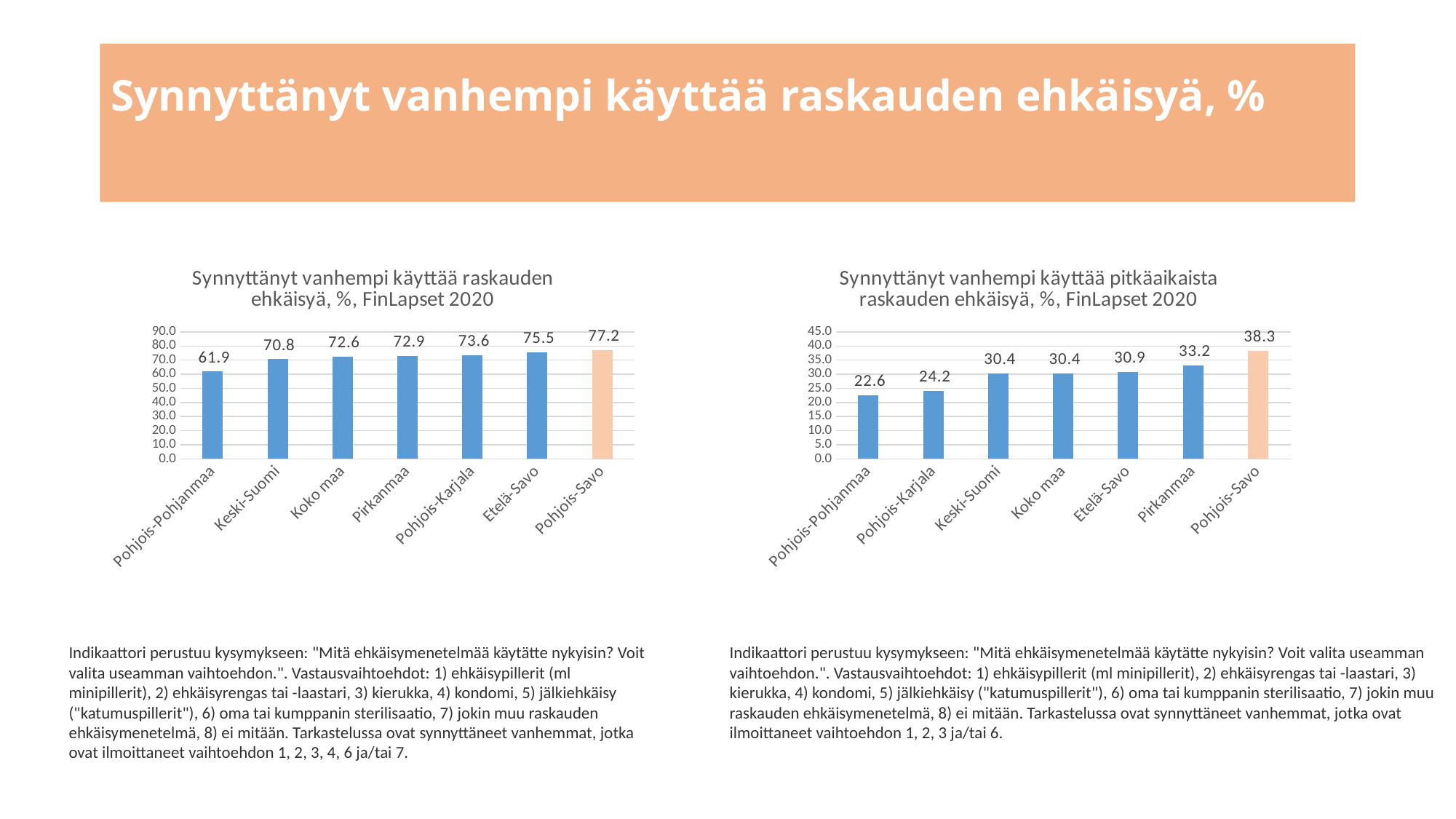
In the right chart (Synnyttänyt vanhempi käyttää pitkäaikaista raskauden ehkäisyä), what is the value for Pirkanmaa? 33.2 In the left chart (Synnyttänyt vanhempi käyttää raskauden ehkäisyä), which region has the lowest value? Pohjois-Pohjanmaa In the right chart (Synnyttänyt vanhempi käyttää pitkäaikaista raskauden ehkäisyä), which is larger, Etelä-Savo or Pohjois-Pohjanmaa? Etelä-Savo In the left chart (Synnyttänyt vanhempi käyttää raskauden ehkäisyä), do the values rise or fall from left to right? Rise In the right chart (Synnyttänyt vanhempi käyttää pitkäaikaista raskauden ehkäisyä), what is the difference between Pohjois-Savo and Koko maa? 7.9 In the left chart (Synnyttänyt vanhempi käyttää raskauden ehkäisyä), which region has the highest value? Pohjois-Savo In the right chart (Synnyttänyt vanhempi käyttää pitkäaikaista raskauden ehkäisyä), which region has the highest value? Pohjois-Savo In the left chart (Synnyttänyt vanhempi käyttää raskauden ehkäisyä), how many regions are shown? 7 In the right chart (Synnyttänyt vanhempi käyttää pitkäaikaista raskauden ehkäisyä), what is the value for Pohjois-Karjala? 24.2 In the left chart (Synnyttänyt vanhempi käyttää raskauden ehkäisyä), what is the difference between Pohjois-Savo and Pohjois-Pohjanmaa? 15.3 What kind of chart is the right chart (Synnyttänyt vanhempi käyttää pitkäaikaista raskauden ehkäisyä)? Bar chart In the left chart (Synnyttänyt vanhempi käyttää raskauden ehkäisyä), what is the value for Koko maa? 72.6